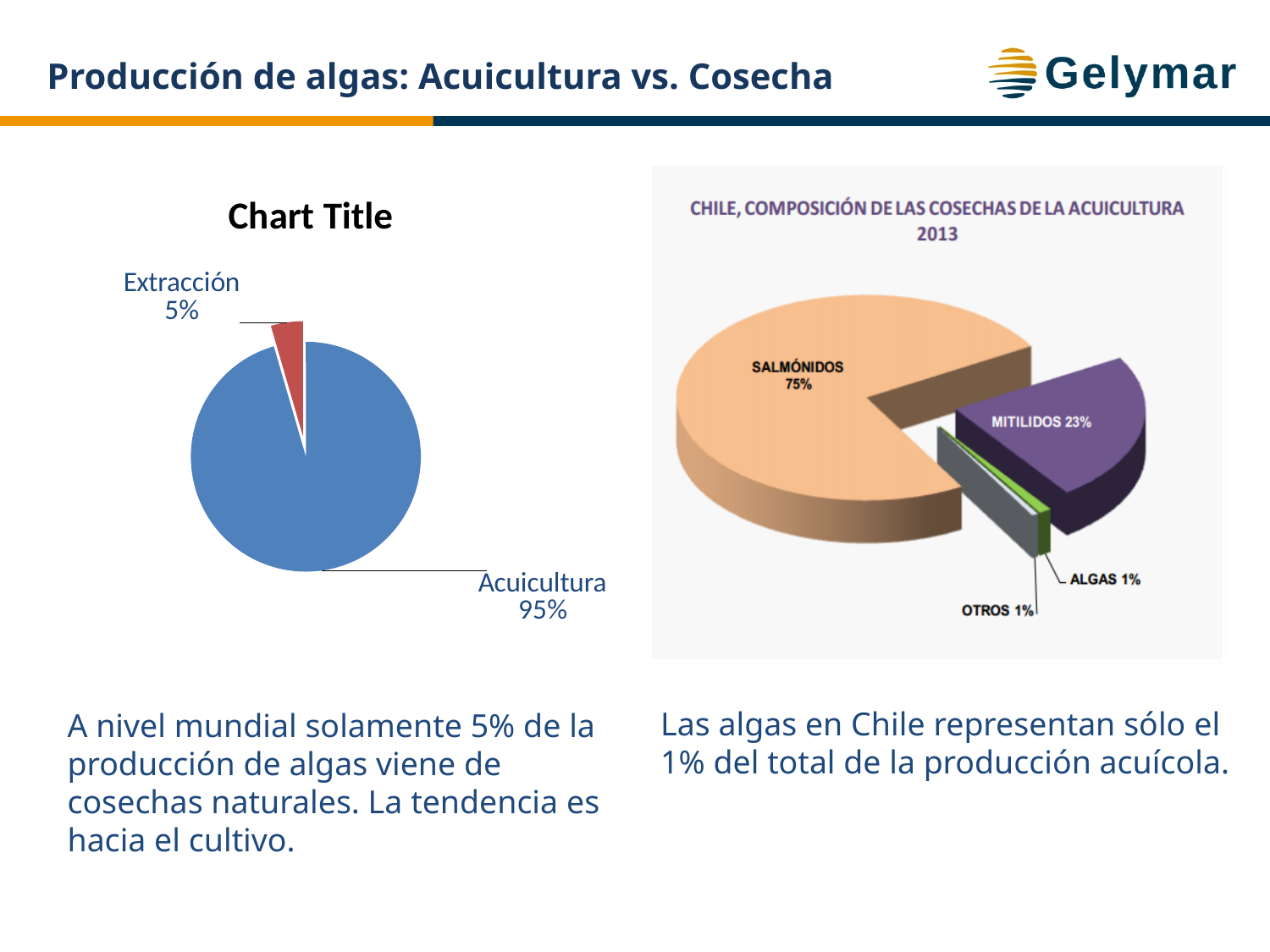
In the right chart 'CHILE, COMPOSICIÓN DE LAS COSECHAS DE LA ACUICULTURA 2013', which category has the largest share? Salmónidos In the left pie chart titled 'Chart Title', what share does Acuicultura have? 95% In the right chart 'CHILE, COMPOSICIÓN DE LAS COSECHAS DE LA ACUICULTURA 2013', what share do Algas have? 1% In the left pie chart titled 'Chart Title', which slice is the largest? Acuicultura What kind of chart is the chart on the left of the slide? Pie chart In the right chart 'CHILE, COMPOSICIÓN DE LAS COSECHAS DE LA ACUICULTURA 2013', what is the difference between the Salmónidos and Mitilidos shares? 52% In the right chart 'CHILE, COMPOSICIÓN DE LAS COSECHAS DE LA ACUICULTURA 2013', how many categories are shown? 4 In the left pie chart titled 'Chart Title', how many slices are there? 2 In the right chart 'CHILE, COMPOSICIÓN DE LAS COSECHAS DE LA ACUICULTURA 2013', what share do Salmónidos have? 75% In the left pie chart titled 'Chart Title', what is the difference between the Acuicultura and Extracción shares? 90%